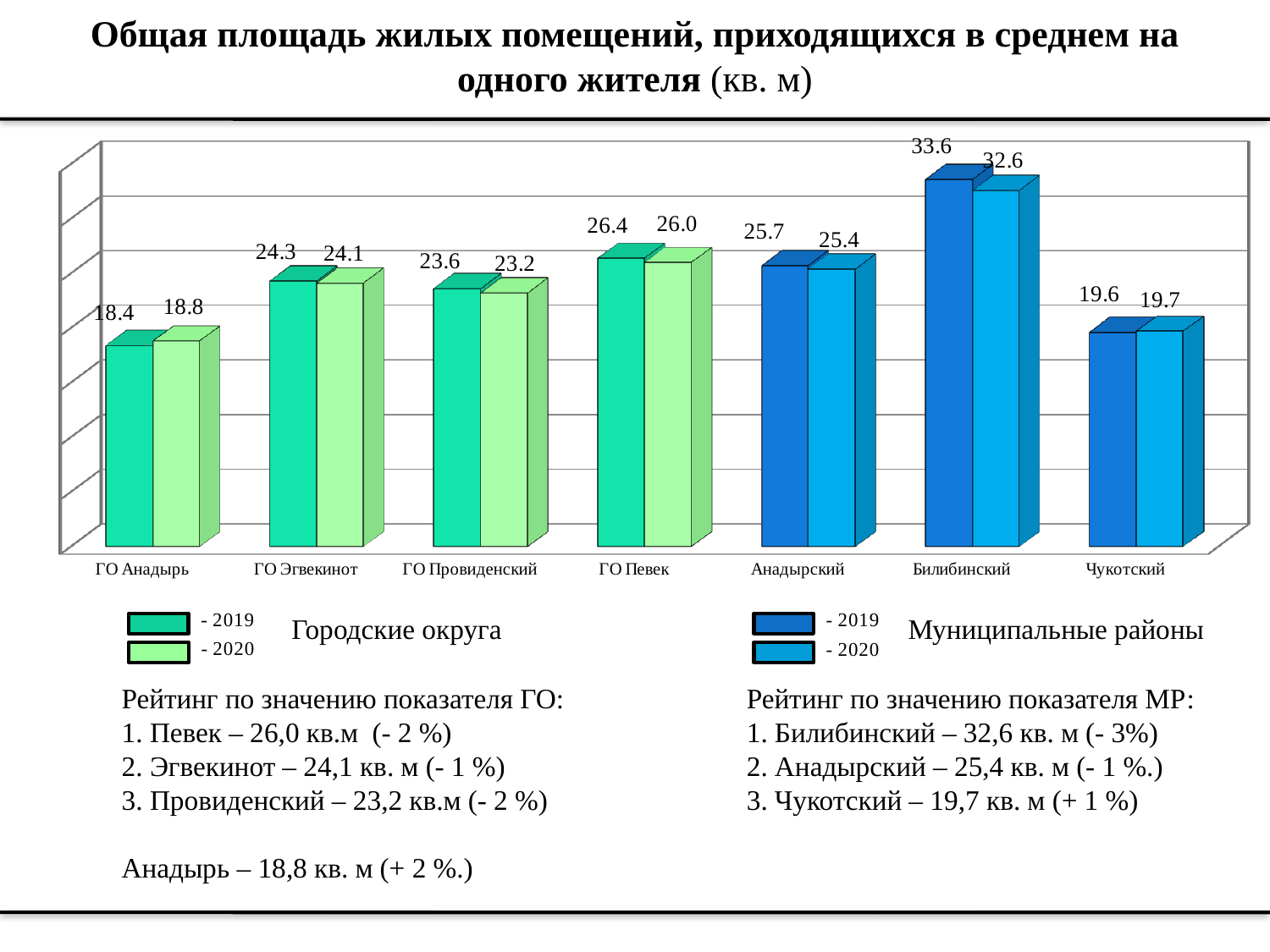
How many categories (territories) are shown on the chart? 7 What type of chart is shown on the slide? Bar chart Which is larger in 2020: ГО Певек or Анадырский? ГО Певек Which category has the lowest 2019 value? ГО Анадырь Did the value for Чукотский rise or fall from 2019 to 2020? Rose Which category has the highest 2020 value? Билибинский What is the 2020 value for Билибинский? 32.6 By how much did the value for Билибинский change from 2019 to 2020? 1.0 Which two years does the chart compare? 2019 and 2020 What is the 2019 value for ГО Певек? 26.4 What is the 2020 value for Чукотский? 19.7 What is the difference between the 2020 and 2019 values for ГО Анадырь? 0.4